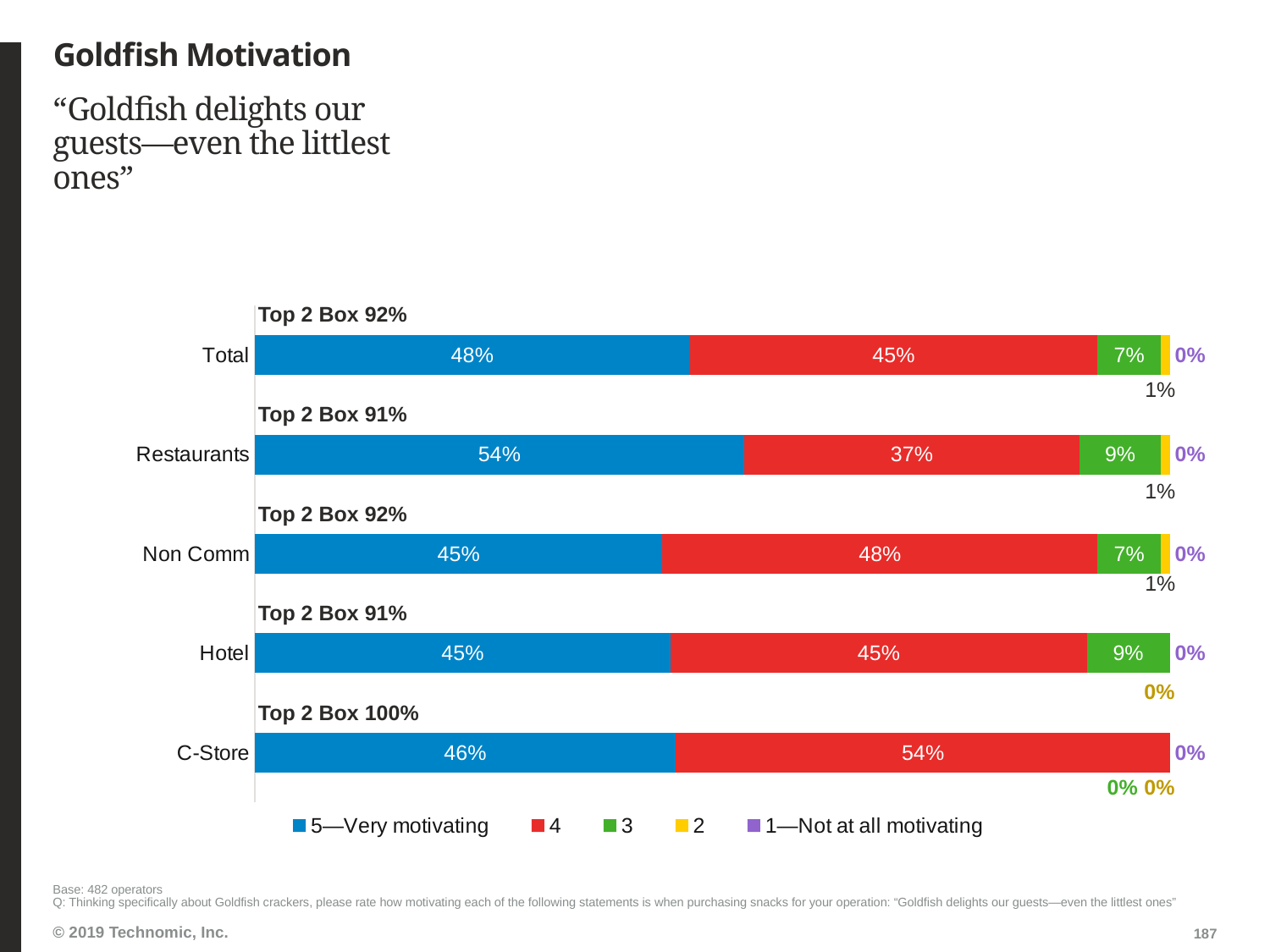
How many series does the legend list? 5 Which colour represents the 3 rating in the legend? Green What is the combined total of the 5—Very motivating and 4 ratings for Total? 93% What percentage of Restaurants rated the statement 5—Very motivating? 54% Which category has the highest 5—Very motivating percentage? Restaurants Which is larger for Non Comm: the 5—Very motivating share or the 4 share? 4 What kind of chart is shown on the slide? Stacked bar chart What is the Top 2 Box value shown for Hotel? Top 2 Box 91% What is the difference between the 5—Very motivating percentages for Restaurants and Non Comm? 9% What is the value for the 4 rating in the C-Store bar? 54% Which category has the lowest 4 rating percentage? Restaurants How many categories are shown on the chart? 5